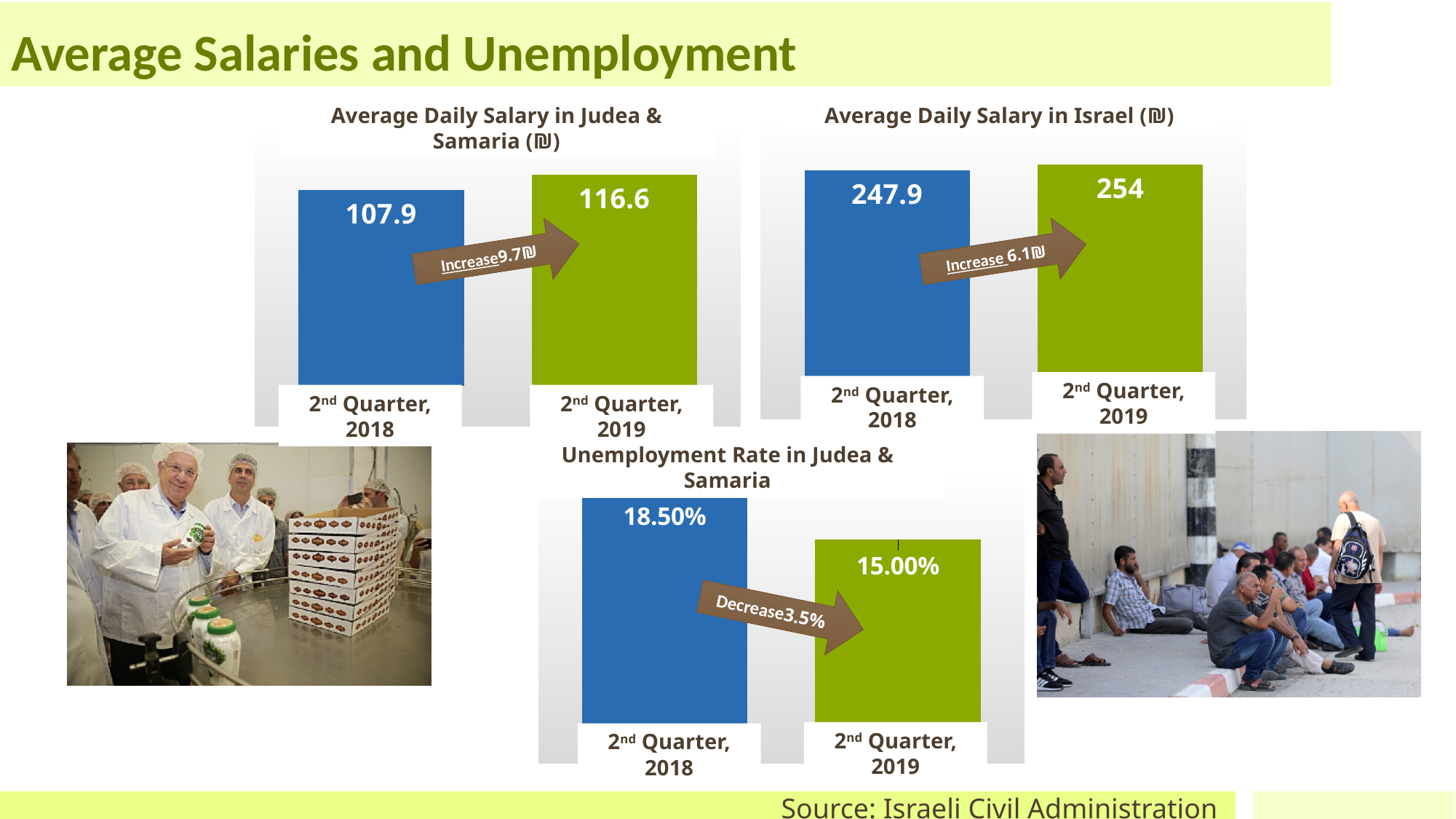
In the 'Unemployment Rate in Judea & Samaria' chart, what is the value for 2nd Quarter, 2019? 15.00% In the 'Unemployment Rate in Judea & Samaria' chart, do values rise or fall from 2nd Quarter, 2018 to 2nd Quarter, 2019? fall In the 'Average Daily Salary in Israel' chart, what is the difference between the 2nd Quarter, 2019 and 2nd Quarter, 2018 values? 6.1 In the 'Average Daily Salary in Israel' chart, what is the value for 2nd Quarter, 2018? 247.9 In the 'Unemployment Rate in Judea & Samaria' chart, which quarter has the higher value? 2nd Quarter, 2018 In the 'Average Daily Salary in Israel' chart, what is the value for 2nd Quarter, 2019? 254 In the 'Average Daily Salary in Judea & Samaria' chart, what is the value for 2nd Quarter, 2018? 107.9 What kind of chart is the 'Average Daily Salary in Israel' chart? bar chart In the 'Average Daily Salary in Judea & Samaria' chart, which quarter has the lower value? 2nd Quarter, 2018 In the 'Unemployment Rate in Judea & Samaria' chart, what is the value for 2nd Quarter, 2018? 18.50% In the 'Average Daily Salary in Judea & Samaria' chart, what is the value for 2nd Quarter, 2019? 116.6 How many bars are in the 'Average Daily Salary in Judea & Samaria' chart? 2